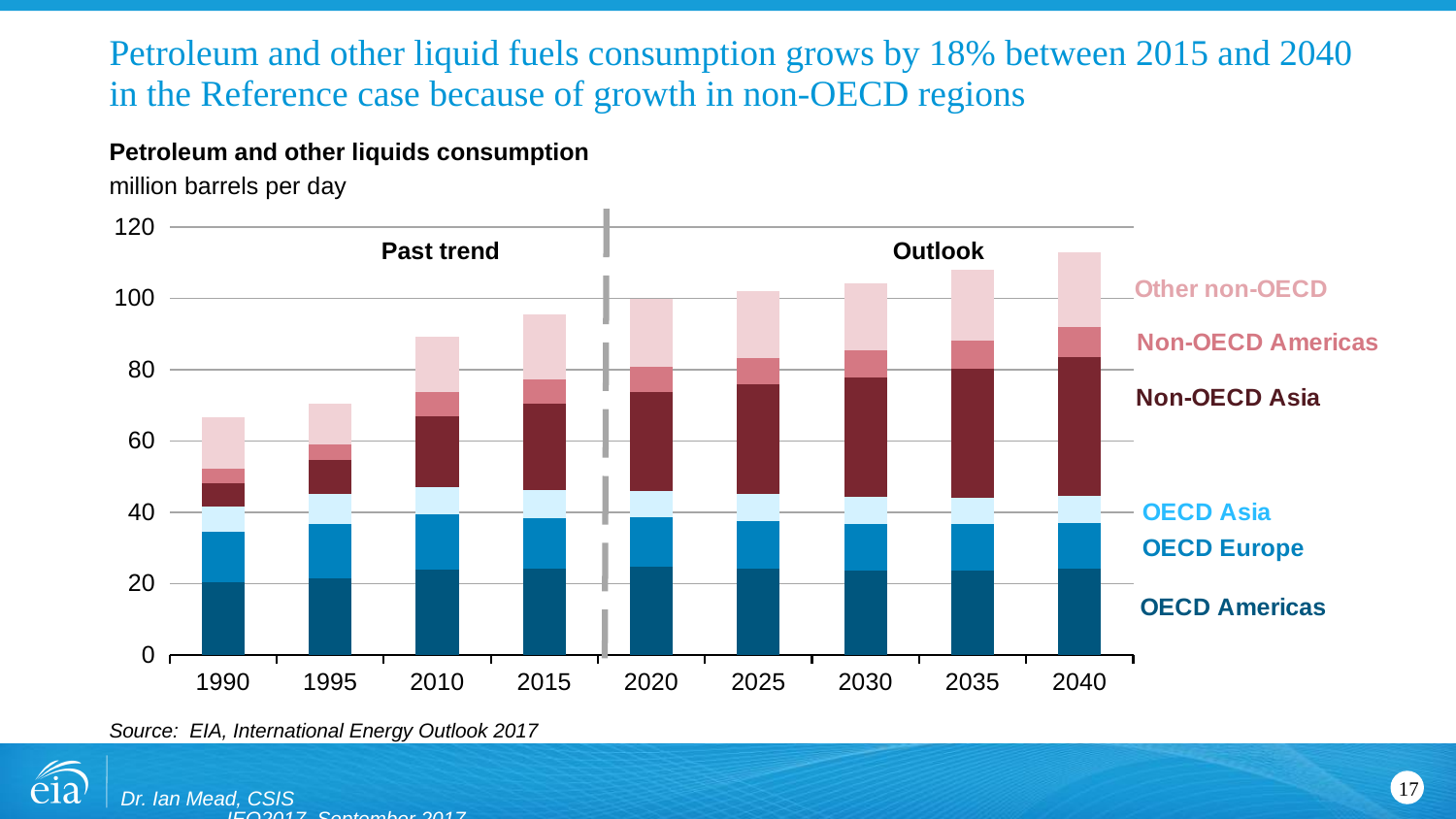
Which year has the lowest total petroleum and other liquids consumption? 1990 How many years are shown along the x axis of the chart? 9 Do total consumption values rise or fall from 1990 to 2040? rise Is the total consumption for 1990 greater or less than 80 million barrels per day? less Is the total consumption for 2010 greater or less than 80 million barrels per day? greater Which year has the larger total consumption, 1995 or 2020? 2020 Which year has the highest total petroleum and other liquids consumption? 2040 What kind of chart is shown on the slide? Stacked bar chart Is the total consumption for 2040 greater or less than 100 million barrels per day? greater What are the two labels that divide the chart into the historical and projected periods? Past trend and Outlook What unit is the chart's data measured in? million barrels per day How many series (regions) does the chart's legend list? 6